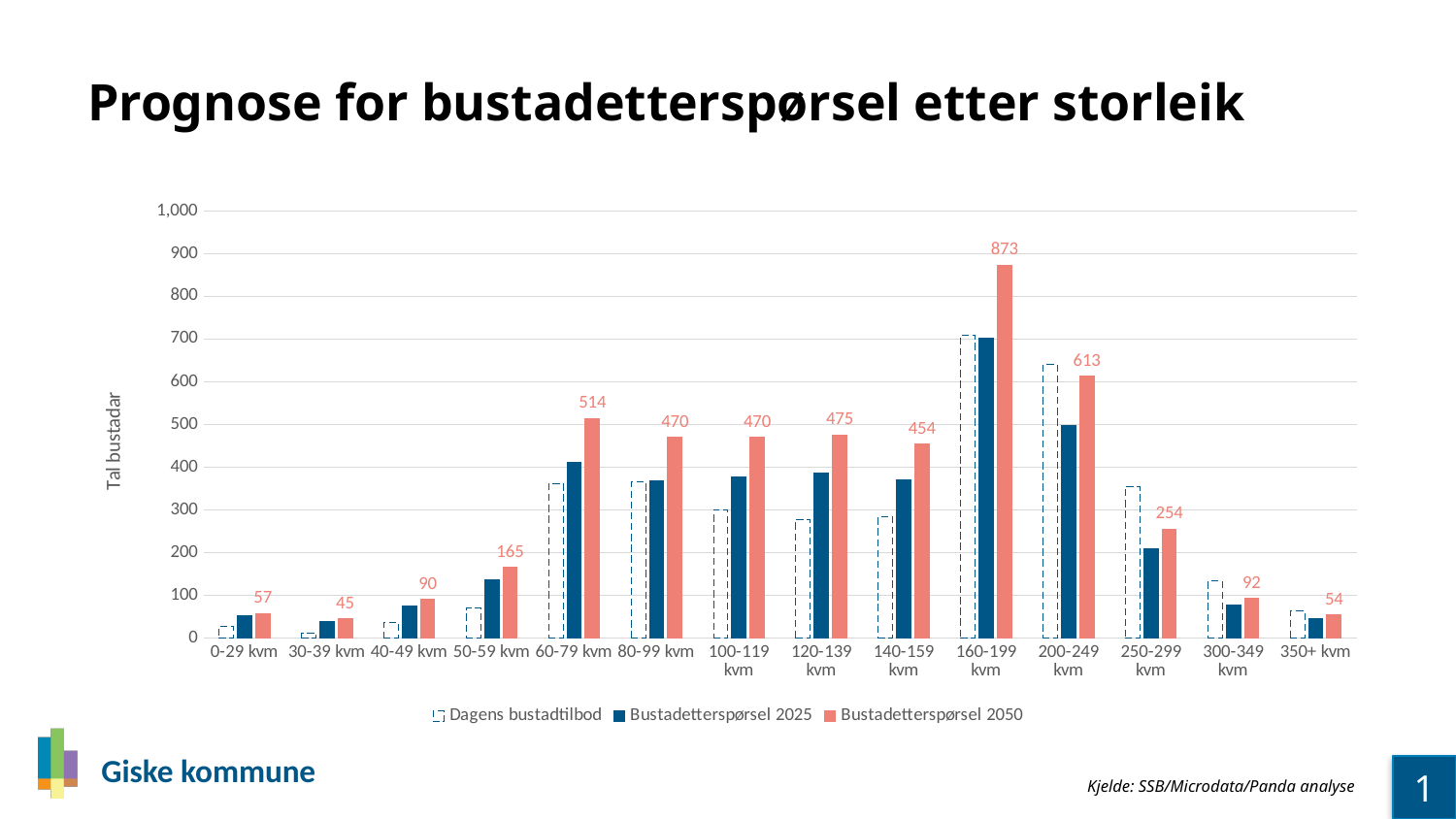
Which is larger: the Bustadetterspørsel 2050 value for 250-299 kvm or for 140-159 kvm? 140-159 kvm Which category has the highest Bustadetterspørsel 2050 value? 160-199 kvm What is the value of Bustadetterspørsel 2050 for 160-199 kvm? 873 What is the difference between the Bustadetterspørsel 2050 values for 160-199 kvm and 200-249 kvm? 260 What is the value of Bustadetterspørsel 2050 for 60-79 kvm? 514 What is the value of Bustadetterspørsel 2050 for 30-39 kvm? 45 What type of chart is shown on the slide? Bar chart How many size categories are shown on the x axis? 14 Is the Dagens bustadtilbod value for 120-139 kvm greater or less than 300? less How many series does the legend list? 3 Which category has the lowest Bustadetterspørsel 2050 value? 30-39 kvm Is the Bustadetterspørsel 2025 value for 160-199 kvm greater or less than 600? greater